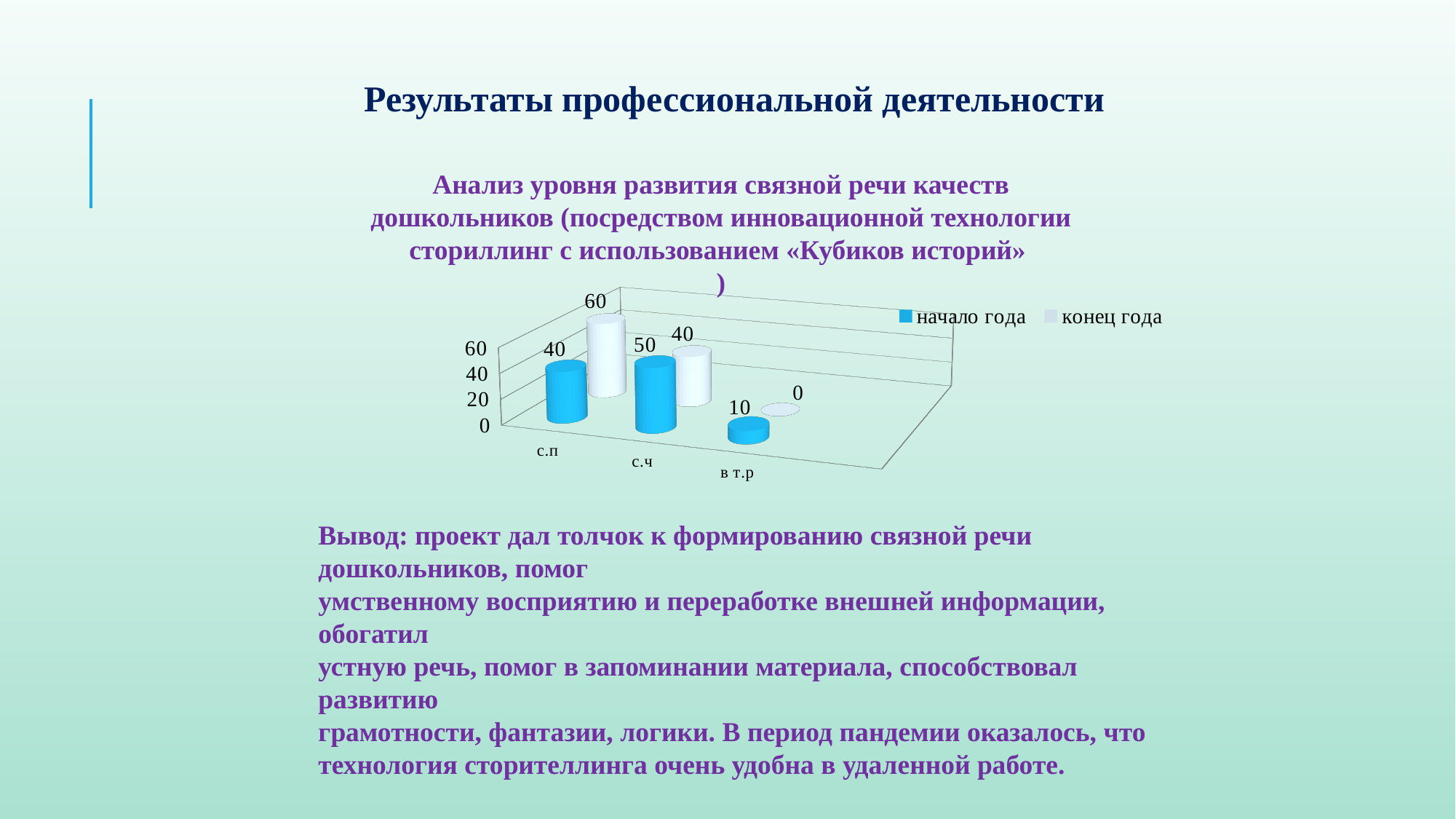
What is the value for в т.р in the конец года series? 0 How many series does the legend list? 2 How many categories are shown on the x axis? 3 Which category has the highest value in the начало года series? с.ч What is the difference between the конец года and начало года values for с.п? 20 For с.ч, which is larger: the начало года value or the конец года value? начало года Which series is shown in blue according to the legend? начало года What is the value for с.ч in the начало года series? 50 Which category has the lowest value in the конец года series? в т.р What kind of chart is shown on the slide? bar chart What is the value for с.п in the начало года series? 40 What is the value for с.п in the конец года series? 60